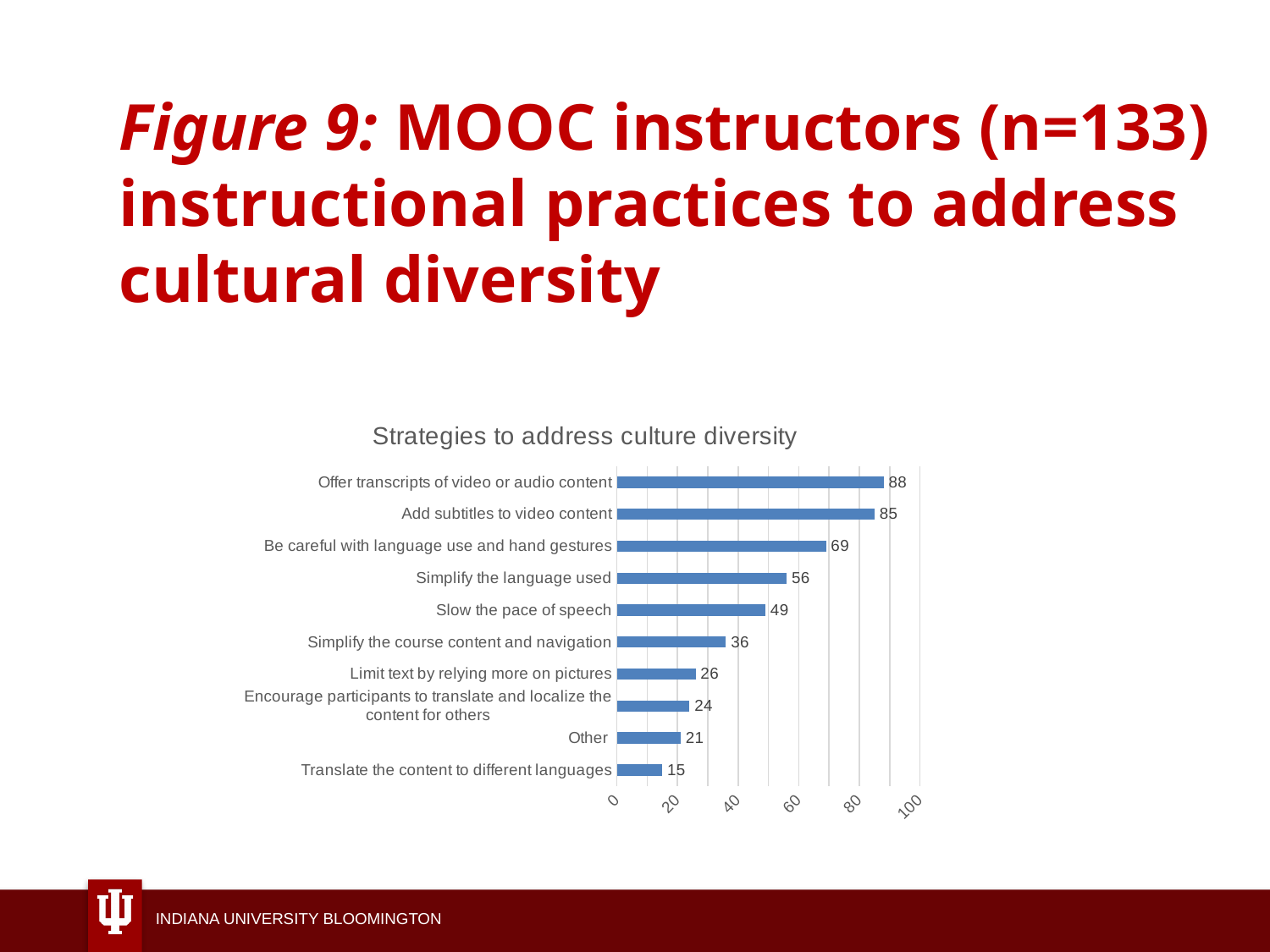
How many strategies are shown in the chart? 10 What is the title of the chart? Strategies to address culture diversity What is the difference between the values for "Be careful with language use and hand gestures" and "Simplify the course content and navigation"? 33 What is the difference between the values for "Add subtitles to video content" and "Simplify the language used"? 29 What is the value for "Other"? 21 What is the value for "Slow the pace of speech"? 49 What kind of chart is shown on the slide? Bar chart Is the value for "Simplify the language used" greater or less than 40? greater Which strategy has the lowest value? Translate the content to different languages Which strategy has the highest value? Offer transcripts of video or audio content What is the value for "Offer transcripts of video or audio content"? 88 Which is larger: the value for "Limit text by relying more on pictures" or the value for "Encourage participants to translate and localize the content for others"? Limit text by relying more on pictures